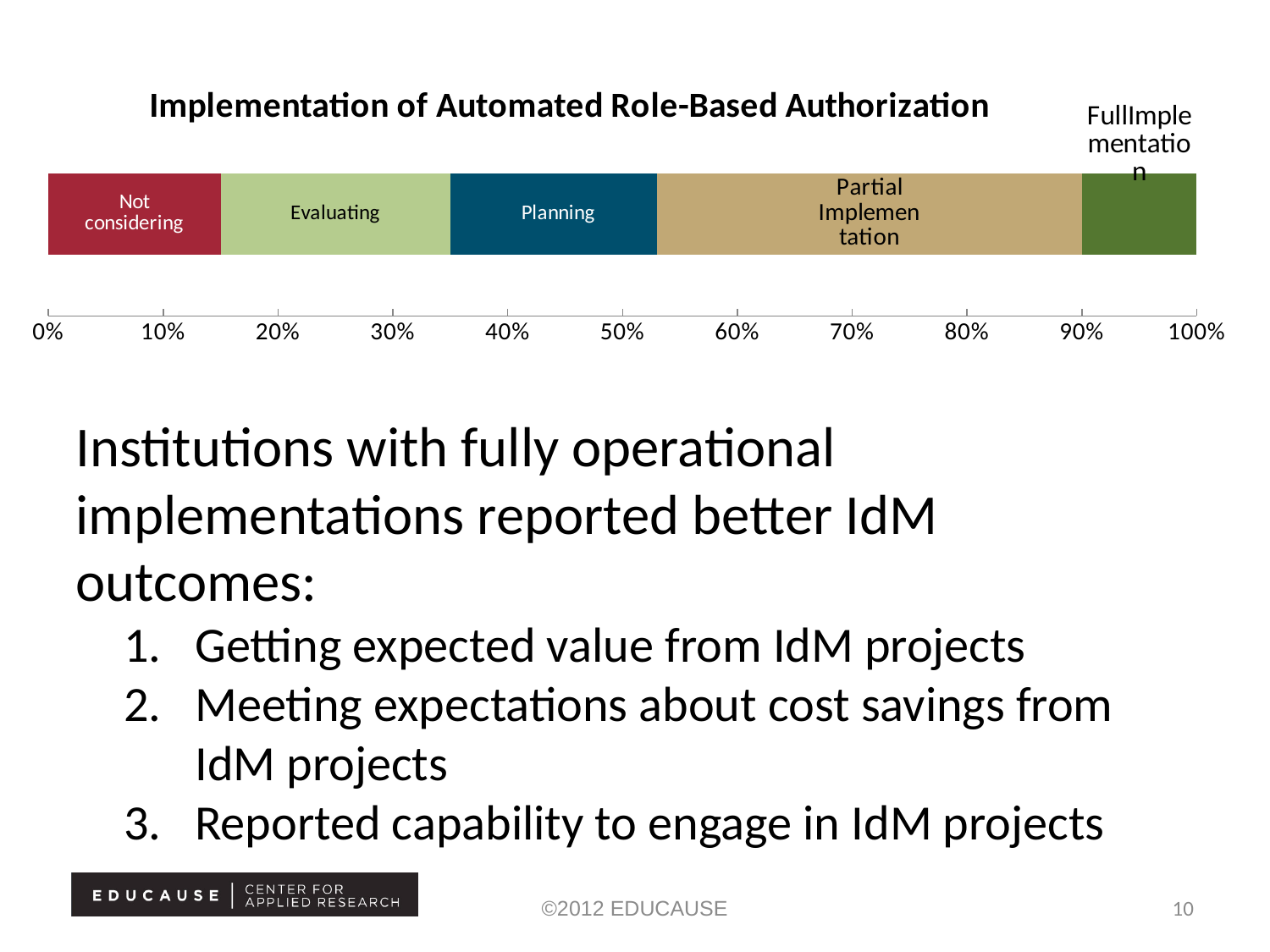
Which segment of the bar is the largest? Partial Implementation Is the share for Not considering greater or less than 20%? less Which segment of the bar is the smallest? Full Implementation Is the share for Full Implementation greater or less than 20%? less Which segment is larger, Partial Implementation or Planning? Partial Implementation What kind of chart is shown on the slide? Stacked bar chart What is the title of the chart? Implementation of Automated Role-Based Authorization Is the share for Partial Implementation greater or less than 30%? greater What is the highest value shown on the x axis? 100% Which segment appears first (leftmost) in the stacked bar? Not considering How many segments (categories) make up the stacked bar? 5